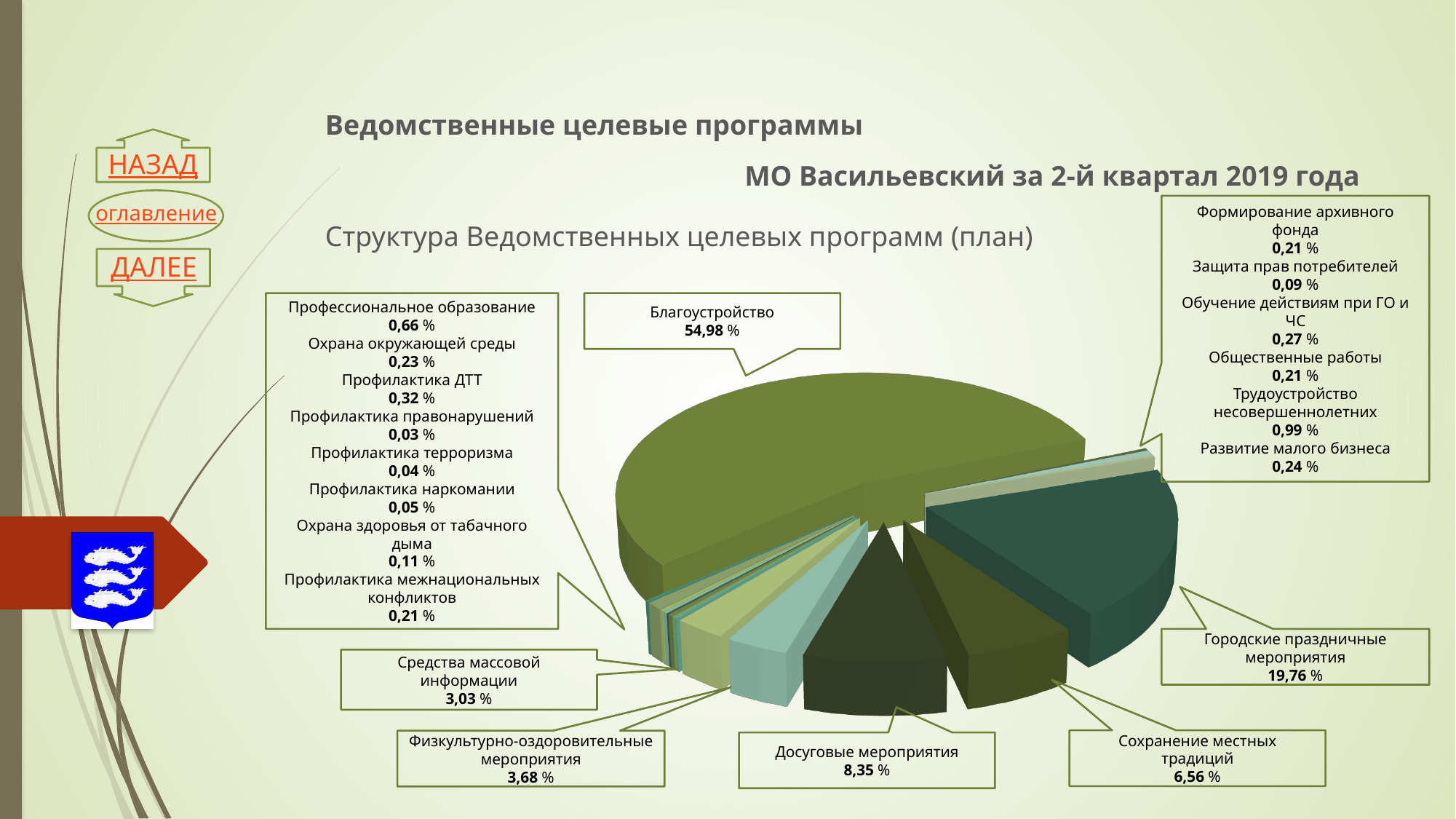
What kind of chart is shown on the slide? Pie chart Which is larger: Физкультурно-оздоровительные мероприятия or Средства массовой информации? Физкультурно-оздоровительные мероприятия What is the title of the chart? Структура Ведомственных целевых программ (план) Which category has the largest share of the pie? Благоустройство How many categories are labelled in the pie chart? 20 What is the difference between the shares of Благоустройство and Городские праздничные мероприятия? 35,22 % What is the value for Досуговые мероприятия? 8,35 % What is the difference between the shares of Досуговые мероприятия and Сохранение местных традиций? 1,79 % What share does Благоустройство have in the pie chart? 54,98 % What is the value for Трудоустройство несовершеннолетних? 0,99 % Which category has the smallest share of the pie? Профилактика правонарушений What is the value for Городские праздничные мероприятия? 19,76 %